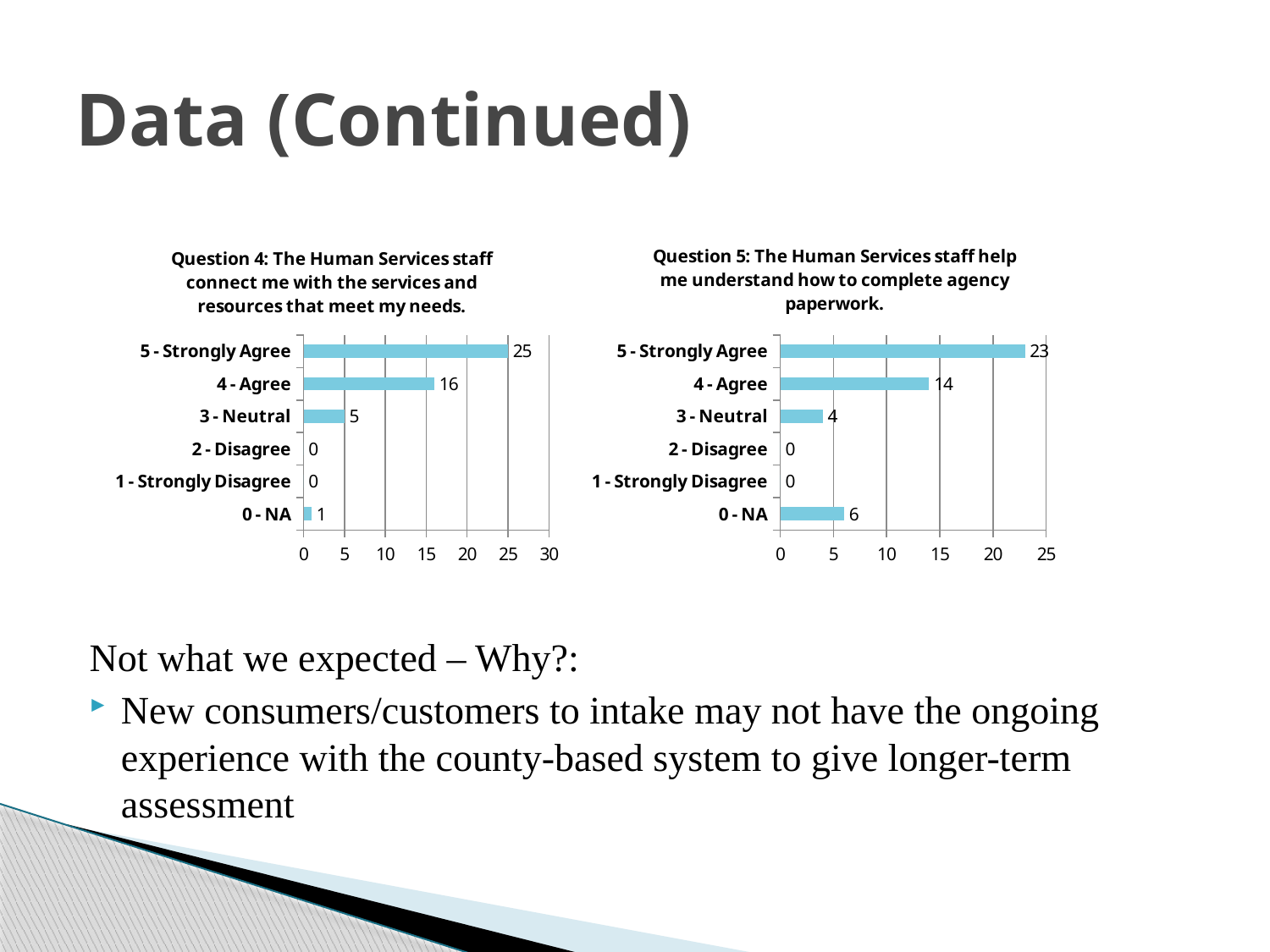
In the Question 4 chart, which category has the highest value? 5 - Strongly Agree Which is larger: 3 - Neutral in the Question 4 chart or 0 - NA in the Question 5 chart? 0 - NA in the Question 5 chart In the Question 5 chart, what is the value for 0 - NA? 6 In the Question 4 chart, what is the value for 5 - Strongly Agree? 25 In the Question 4 chart, how many categories have a value of 0? 2 What kind of chart is the Question 5 chart? Bar chart How many categories does the Question 4 chart show? 6 In the Question 4 chart, what is the difference between 5 - Strongly Agree and 4 - Agree? 9 In the Question 5 chart, which category has the highest value? 5 - Strongly Agree What is the maximum value shown on the x axis of the Question 5 chart? 25 In the Question 5 chart, what is the difference between 4 - Agree and 3 - Neutral? 10 In the Question 5 chart, what is the value for 4 - Agree? 14